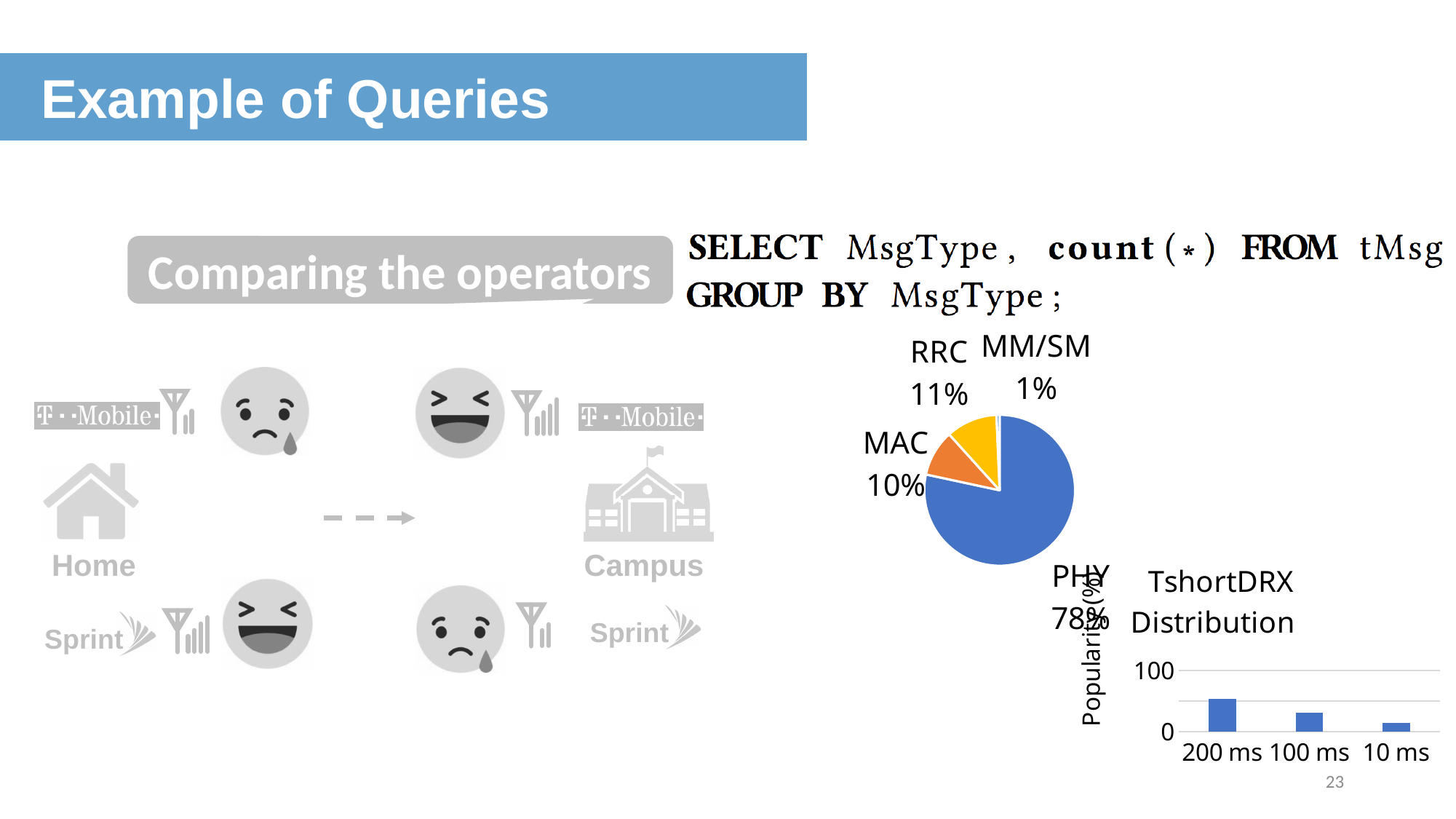
In the pie chart, what is the difference between the PHY share and the RRC share? 67% In the pie chart, which message type has the smallest share? MM/SM In the pie chart, what share does PHY have? 78% In the pie chart, how many slices are there? 4 In the TshortDRX Distribution chart, which category has the shortest bar? 10 ms In the pie chart, what share does MAC have? 10% What kind of chart is the TshortDRX Distribution chart? bar chart In the pie chart, what share does MM/SM have? 1% In the pie chart, which message type has the largest share? PHY In the pie chart, what share does RRC have? 11% In the TshortDRX Distribution chart, which category has the tallest bar? 200 ms In the TshortDRX Distribution chart, is the value for 200 ms greater or less than 100? less